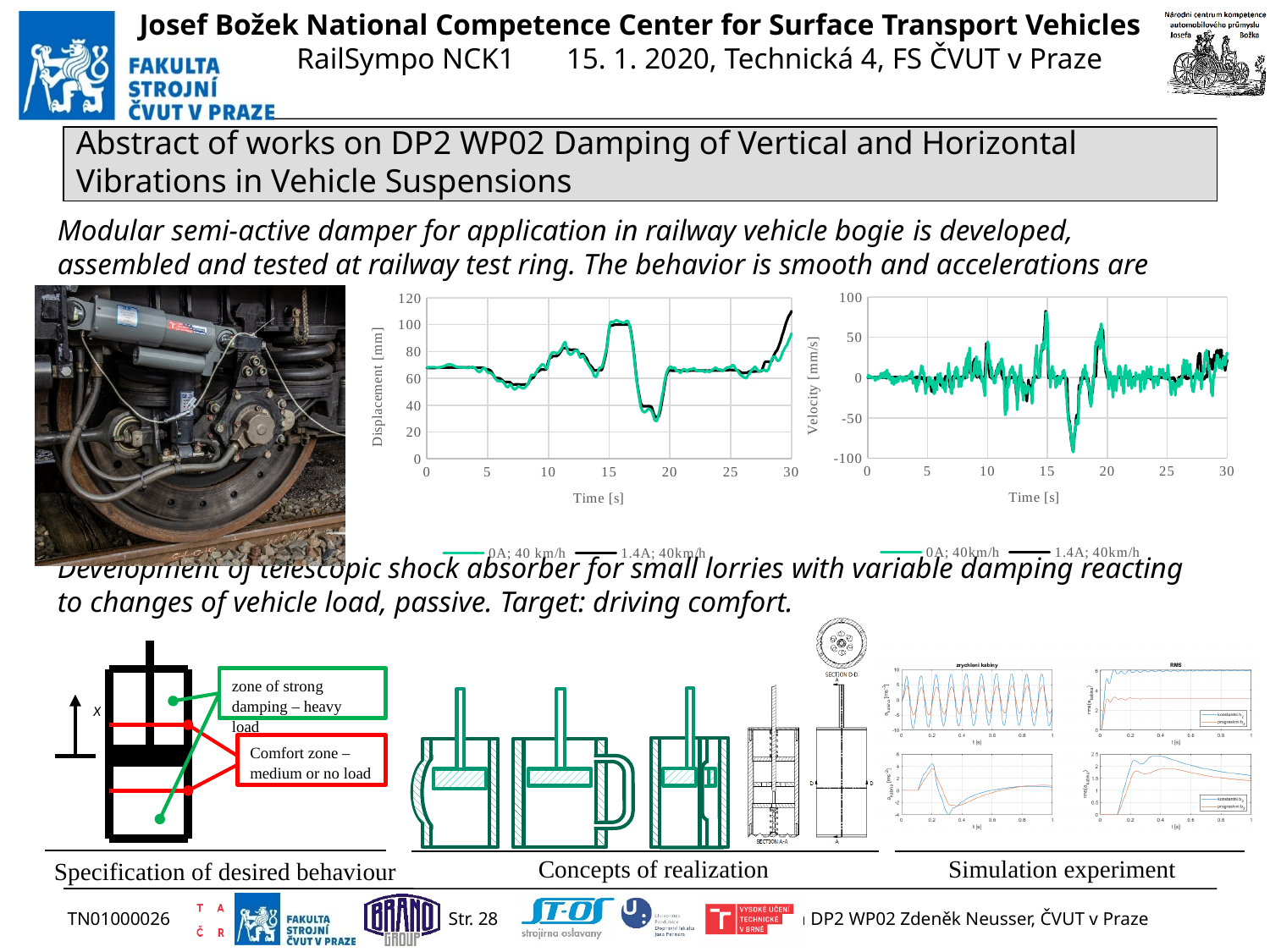
In the Displacement chart, does the displacement rise or fall between about 16 s and 19 s? fall In the Displacement chart, is the displacement value at around 15 s greater or less than 80? greater How many series does the legend of the Velocity chart list? 2 In the Velocity chart, is the lowest velocity value (around 17 s) greater or less than -50? less What kind of chart is the Displacement chart in the upper middle of the slide? line chart What is the y-axis label of the Velocity chart on the upper right of the slide? Velocity [mm/s] In the Displacement chart, which is larger: the displacement at around 15 s or at around 19 s? at around 15 s In the Displacement chart, is the lowest displacement value reached (around 19 s) greater or less than 40? less How many series does the legend of the Displacement chart list? 2 What are the two legend entries of the Displacement chart? 0A; 40 km/h and 1.4A; 40km/h